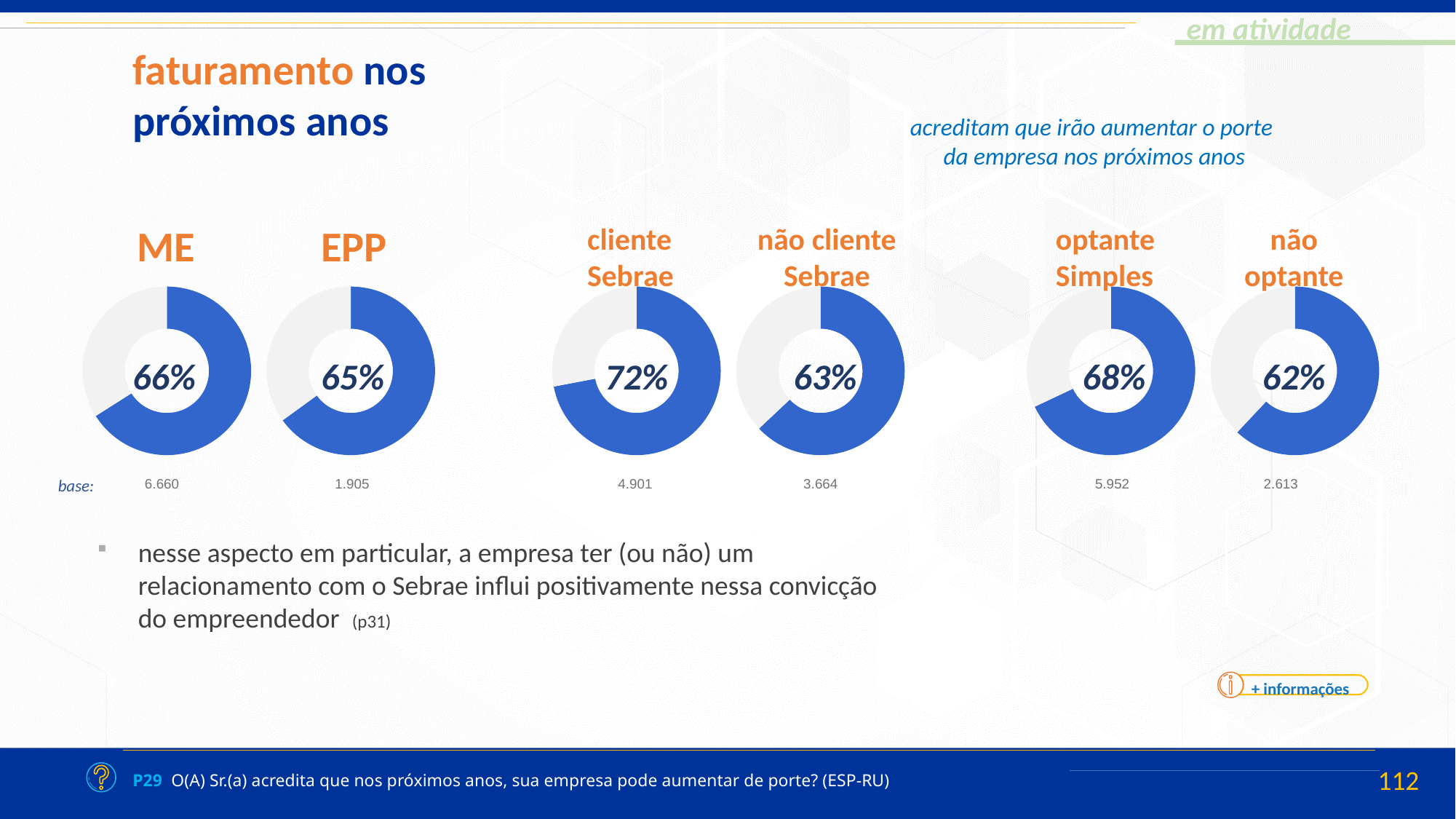
What is the difference in percentage points between the 'cliente Sebrae' and 'não cliente Sebrae' donut charts? 9 What percentage is shown in the 'não optante' donut chart? 62% What percentage is shown in the 'não cliente Sebrae' donut chart? 63% What percentage is shown in the 'optante Simples' donut chart? 68% What percentage is shown in the ME donut chart? 66% Which of the six donut charts shows the highest percentage? cliente Sebrae Which of the six donut charts shows the lowest percentage? não optante What percentage is shown in the EPP donut chart? 65% Which shows a larger percentage, the 'optante Simples' chart or the 'não optante' chart? optante Simples How many donut charts are shown on the slide? 6 What percentage is shown in the 'cliente Sebrae' donut chart? 72% What is the base (number of respondents) shown under the ME donut chart? 6.660